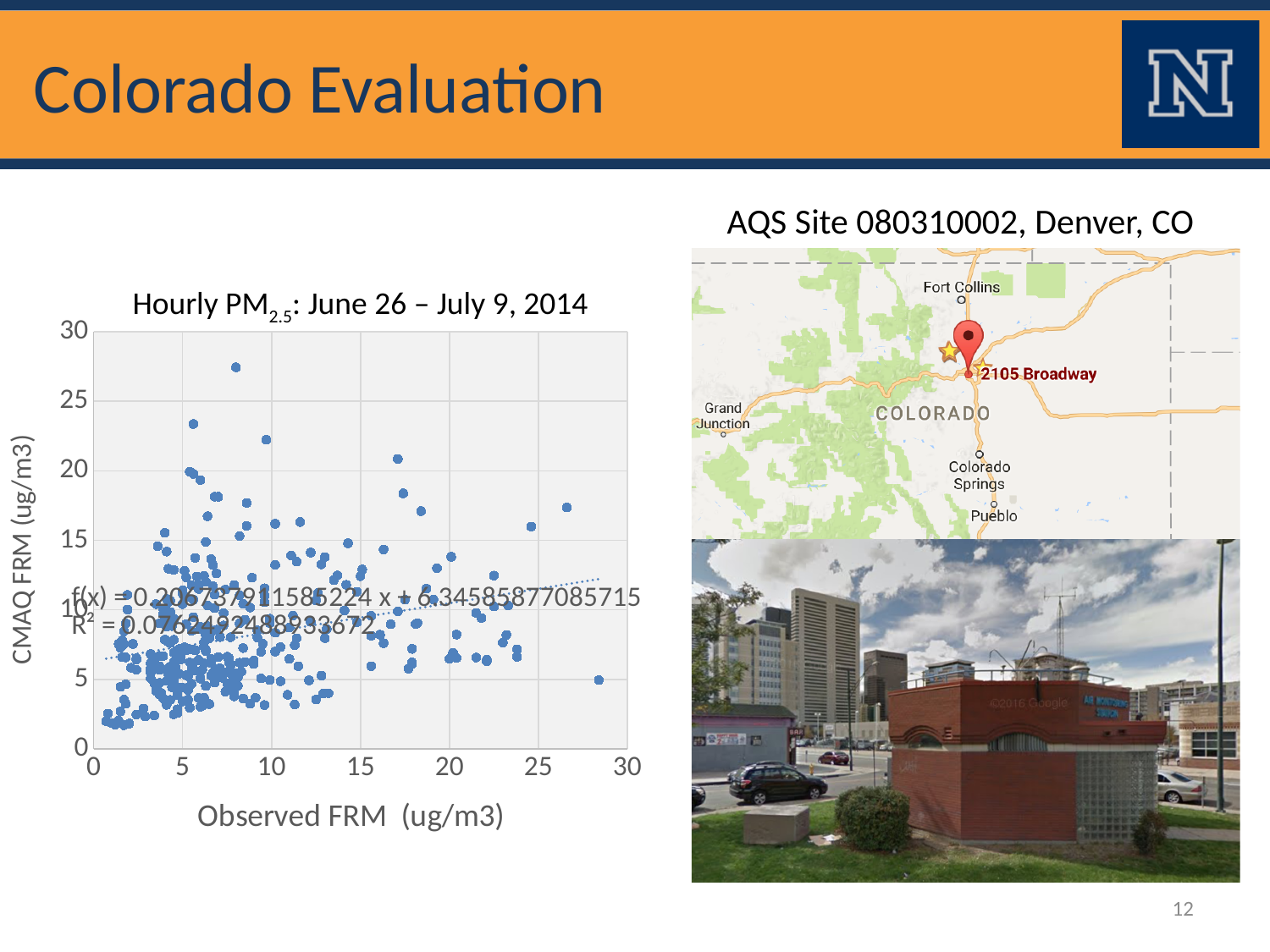
Is the largest Observed FRM value plotted on the chart greater or less than 25? greater According to the fitted trendline, do the CMAQ FRM values rise or fall as Observed FRM increases? Rise What kind of chart is shown on the slide? Scatter chart Is the lowest CMAQ FRM value plotted on the chart greater or less than 5? less Is the highest CMAQ FRM value plotted on the chart greater or less than 25? greater What is the label of the x axis of the chart? Observed FRM (ug/m3) What is the title of the chart on the slide? Hourly PM2.5: June 26 – July 9, 2014 What is the maximum value shown on the y axis of the chart? 30 What is the R² value printed on the chart for the trendline? 0.0762492488933672